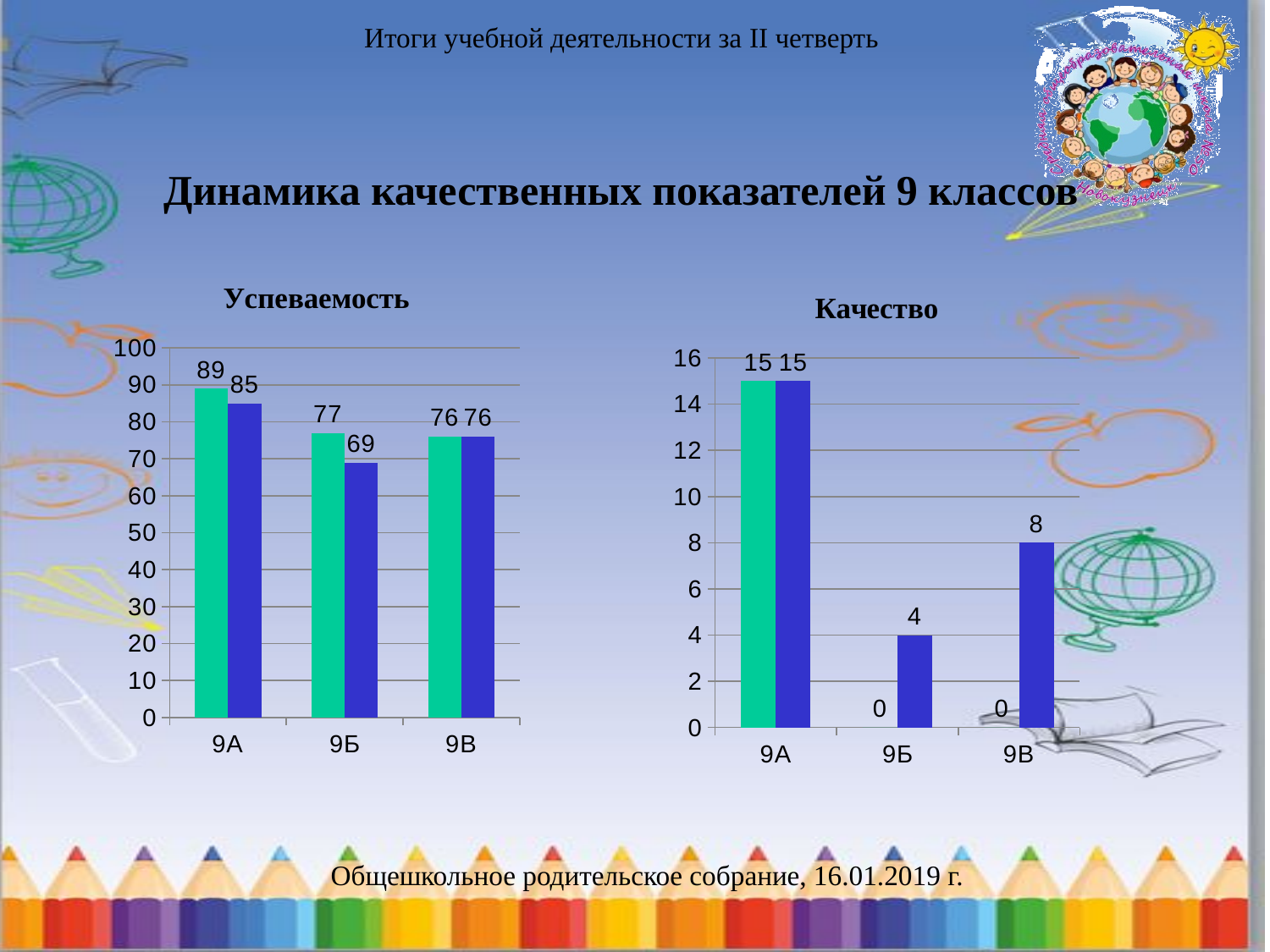
What type of chart is the 'Качество' chart? bar chart In the 'Успеваемость' chart, what is the value of the teal bar for 9А? 89 In the 'Успеваемость' chart, how many categories are shown on the x axis? 3 In the 'Успеваемость' chart, which category has the highest teal bar? 9А In the 'Успеваемость' chart, what is the difference between the teal and blue bars for 9А? 4 In the 'Качество' chart, which category has the highest blue bar? 9А In the 'Качество' chart, what is the value of the teal bar for 9Б? 0 In the 'Качество' chart, is the blue bar for 9Б larger or smaller than the blue bar for 9В? smaller In the 'Успеваемость' chart, what is the value of the blue bar for 9Б? 69 In the 'Успеваемость' chart, which category has the lowest blue bar? 9Б In the 'Качество' chart, what is the value of the blue bar for 9В? 8 In the 'Качество' chart, what is the difference between the blue bars for 9В and 9Б? 4